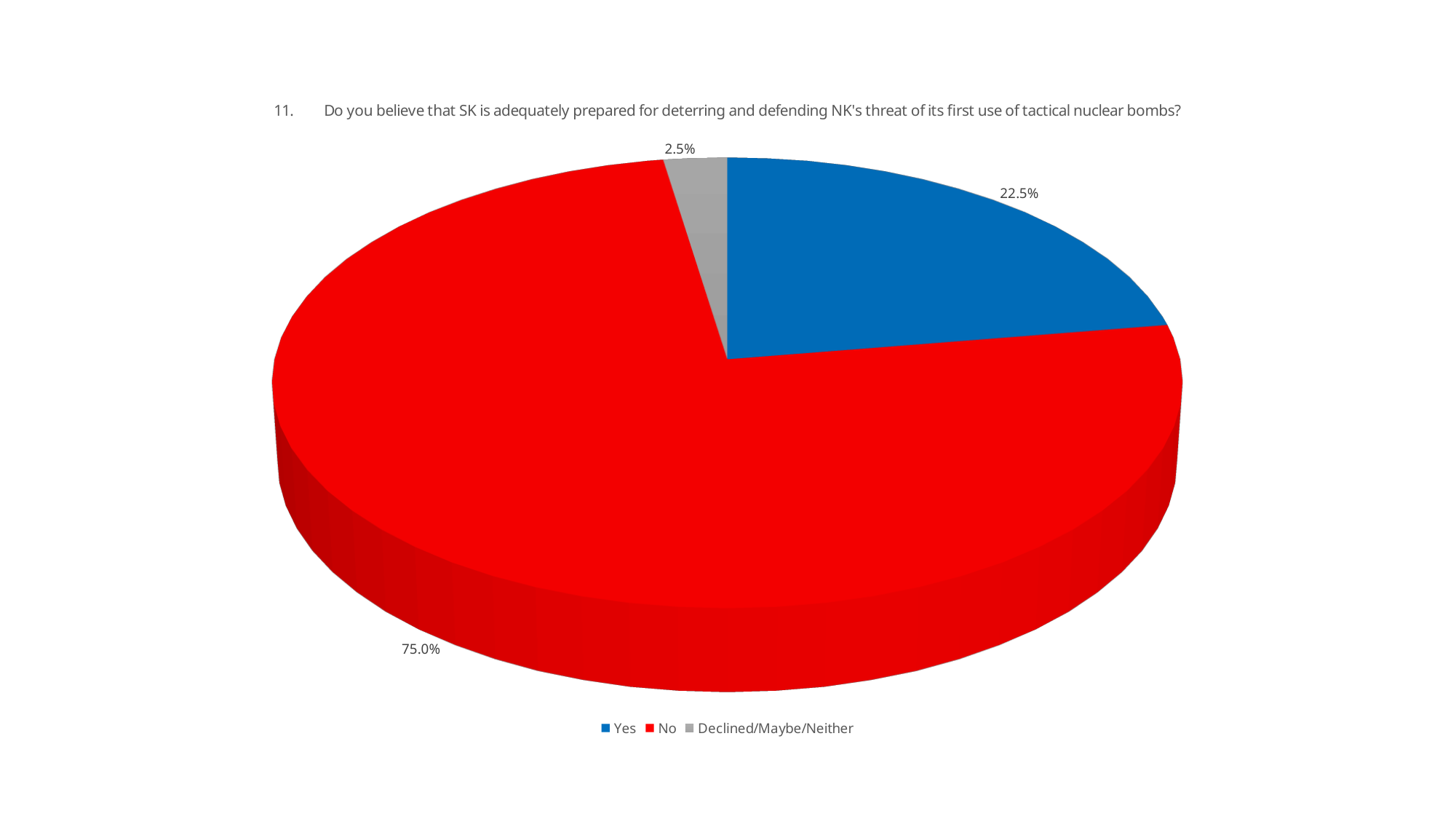
What percentage of respondents are in the "Declined/Maybe/Neither" category? 2.5% How many entries does the legend list? 3 What is the difference in percentage points between the "No" and "Yes" shares? 52.5 What percentage of respondents answered "Yes"? 22.5% What is the combined share of "Yes" and "Declined/Maybe/Neither"? 25.0% What kind of chart is shown on the slide? Pie chart Which response has the largest share of the pie? No What colour is the "No" slice? Red Which is larger, the share for "Yes" or the share for "Declined/Maybe/Neither"? Yes How many categories does the pie chart show? 3 Which response has the smallest share of the pie? Declined/Maybe/Neither What percentage of respondents answered "No"? 75.0%